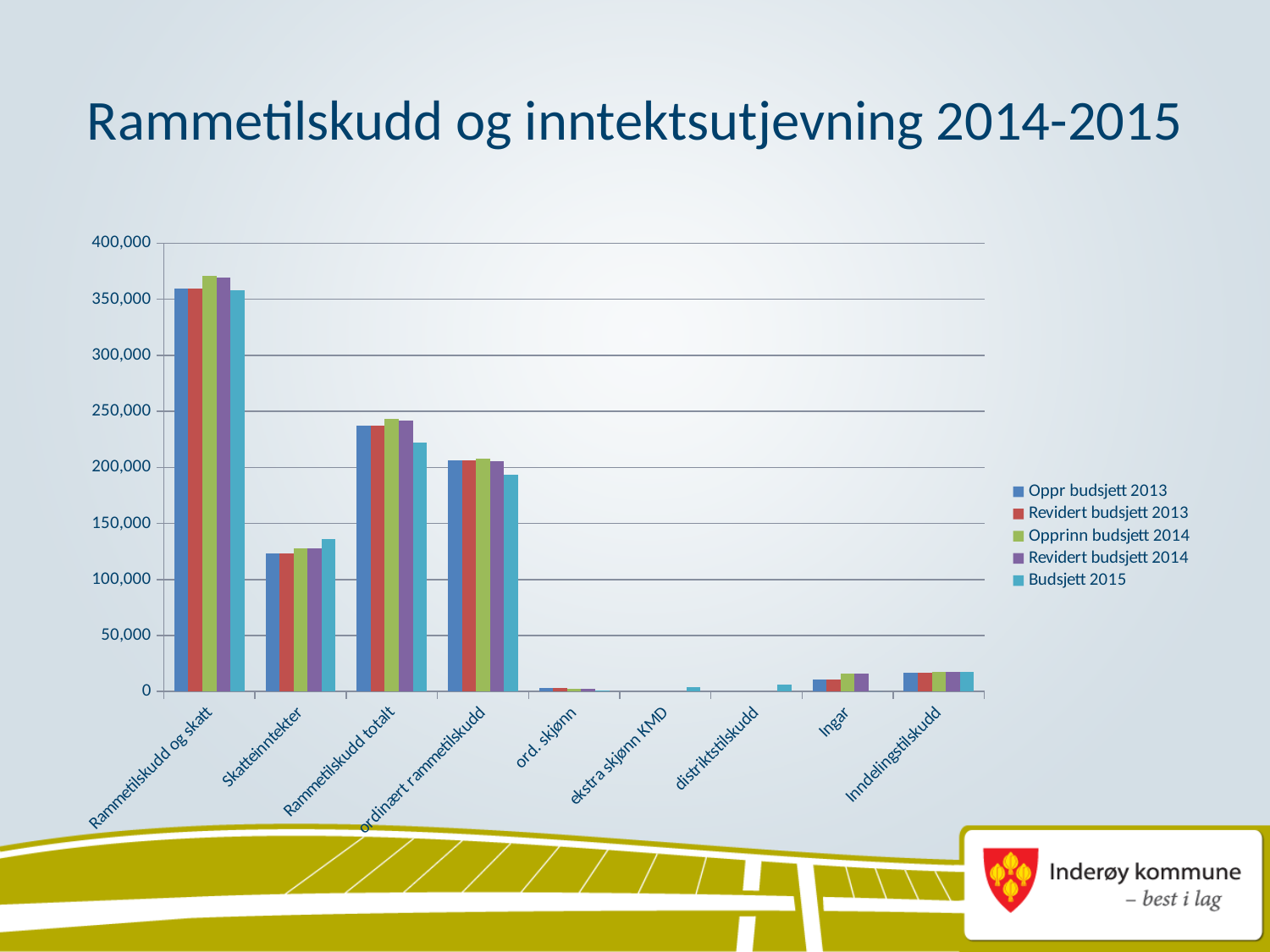
Which category has the highest values in the chart? Rammetilskudd og skatt How many categories are shown along the x axis of the chart? 9 Is the value for Budsjett 2015 in the Skatteinntekter category greater or less than 150,000? less Is the value for Budsjett 2015 in the Rammetilskudd totalt category greater or less than 200,000? greater Is the value for Opprinn budsjett 2014 in the Rammetilskudd og skatt category greater or less than 350,000? greater How many series does the chart's legend list? 5 In the Rammetilskudd totalt category, which is larger: Opprinn budsjett 2014 or Budsjett 2015? Opprinn budsjett 2014 What is the title of the slide containing the chart? Rammetilskudd og inntektsutjevning 2014-2015 What kind of chart is shown on the slide? bar chart Which series is listed last in the chart's legend? Budsjett 2015 In the Skatteinntekter category, which is larger: Oppr budsjett 2013 or Budsjett 2015? Budsjett 2015